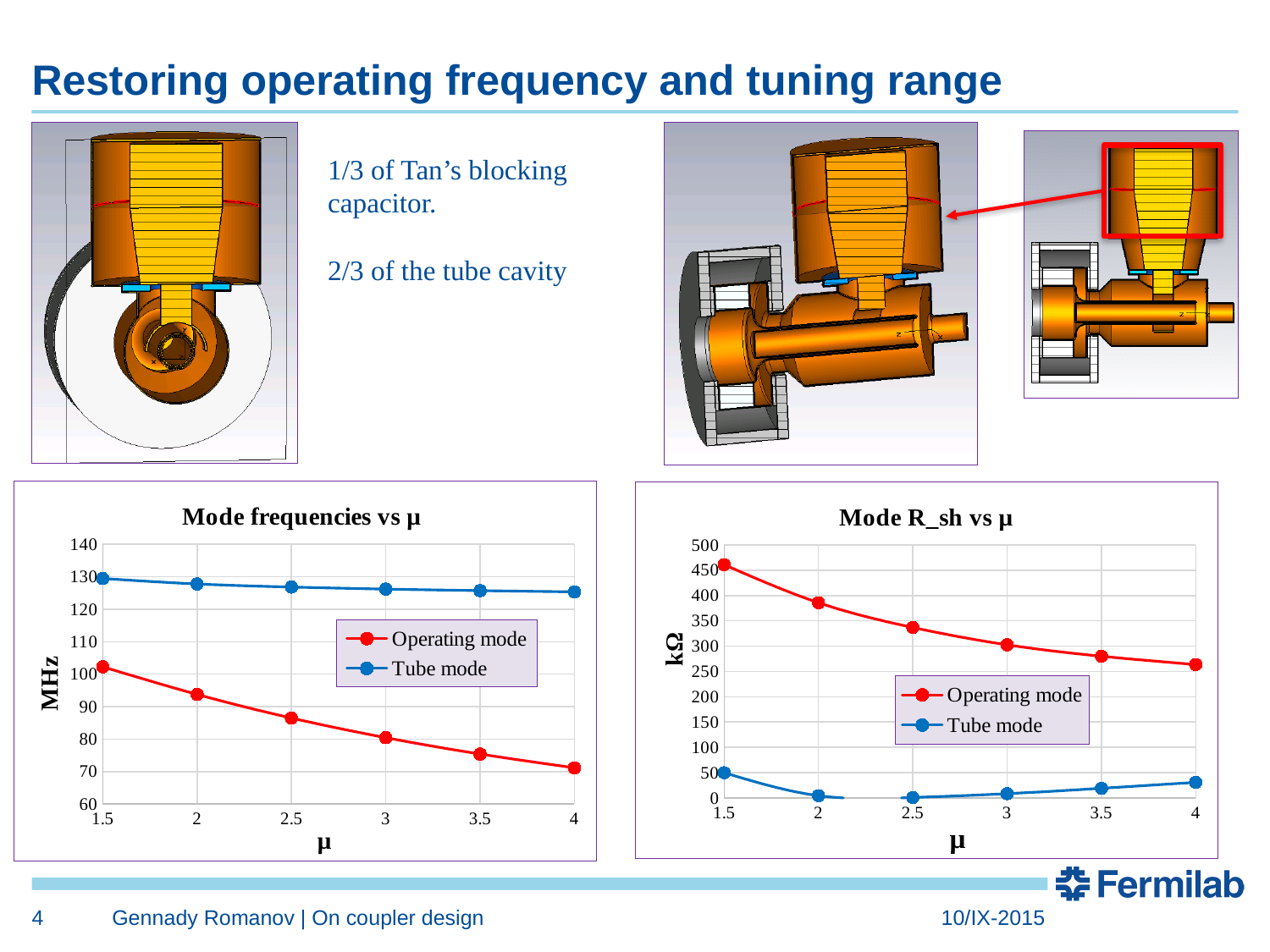
In the 'Mode frequencies vs μ' chart, does the Operating mode frequency rise or fall as μ increases? fall In the 'Mode R_sh vs μ' chart, is the Operating mode value at μ = 4 greater or less than 300? less In the 'Mode R_sh vs μ' chart, does the Operating mode R_sh rise or fall as μ increases? fall In the 'Mode frequencies vs μ' chart, what is the label on the vertical axis? MHz In the 'Mode frequencies vs μ' chart, is the Operating mode value at μ = 4 greater or less than 80? less In the 'Mode frequencies vs μ' chart, what kind of chart is it? line chart In the 'Mode R_sh vs μ' chart, is the Operating mode value at μ = 1.5 greater or less than 400? greater In the 'Mode frequencies vs μ' chart, at μ = 3, which series has the higher value, Operating mode or Tube mode? Tube mode In the 'Mode frequencies vs μ' chart, how many data points are plotted for the Operating mode series? 6 In the 'Mode R_sh vs μ' chart, what is the label on the vertical axis? kΩ In the 'Mode frequencies vs μ' chart, how many series does the legend list? 2 In the 'Mode R_sh vs μ' chart, at which value of μ is the Operating mode R_sh highest? 1.5